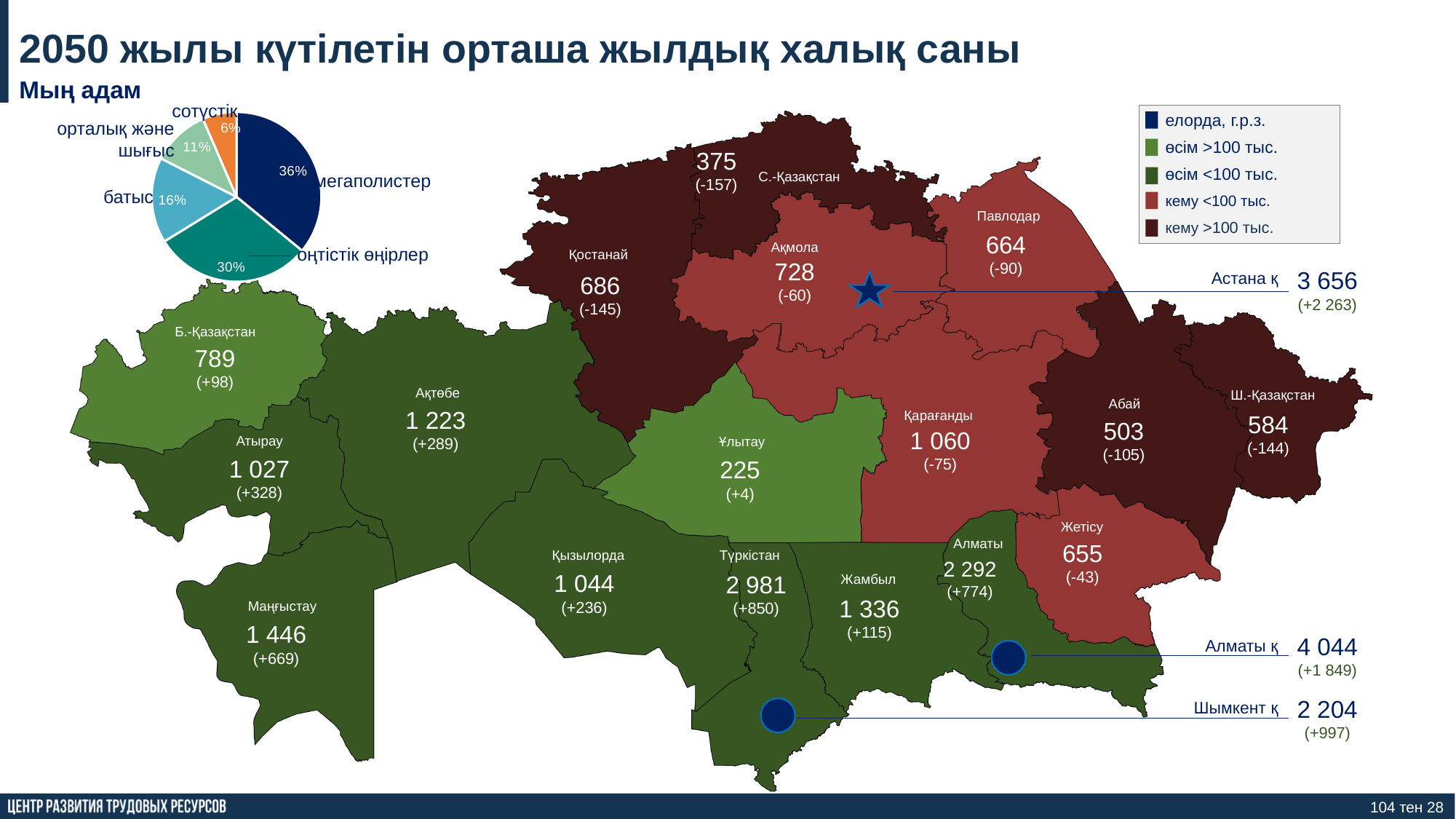
On the pie chart, what is the difference in percentage points between мегаполистер and оңтістік өңірлер? 6 On the pie chart, what share is shown for батыс? 16% On the map, what value is shown for Алматы қ? 4 044 What kind of chart is shown in the top-left of the slide? pie chart On the map, what value is shown for Түркістан? 2 981 On the pie chart, what share is shown for оңтістік өңірлер? 30% On the pie chart, what share is shown for мегаполистер? 36% On the pie chart, what share is shown for солтүстік? 6% On the pie chart, which slice is the largest? мегаполистер On the pie chart, how many slices are there? 5 On the pie chart, which slice is the smallest? солтүстік On the pie chart, which is larger: батыс or орталық және шығыс? батыс